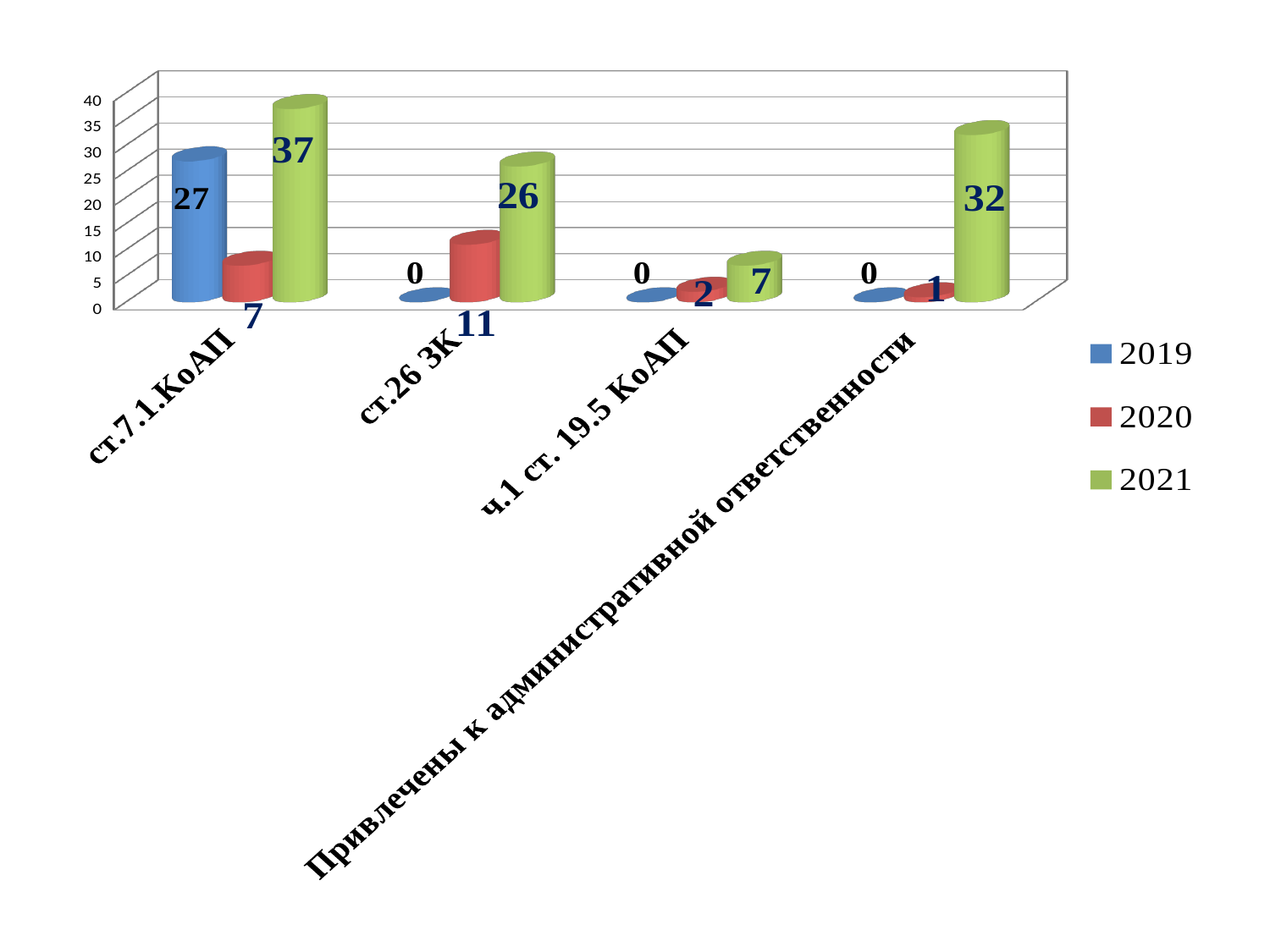
What is the value for 2019 for ст.7.1.КоАП? 27 Which category has the lowest value for 2020? Привлечены к административной ответственности What is the difference between the 2021 and 2019 values for ст.7.1.КоАП? 10 What is the value for 2020 for ст.26 ЗК? 11 Which is larger for ст.26 ЗК: the 2020 value or the 2021 value? 2021 What kind of chart is shown on the slide? bar chart What is the value for 2021 for ст.7.1.КоАП? 37 What is the value for 2021 for Привлечены к административной ответственности? 32 Which category has the highest value for 2021? ст.7.1.КоАП How many categories are shown on the x axis? 4 Which colour represents the 2020 series in the legend? red How many series does the legend list? 3